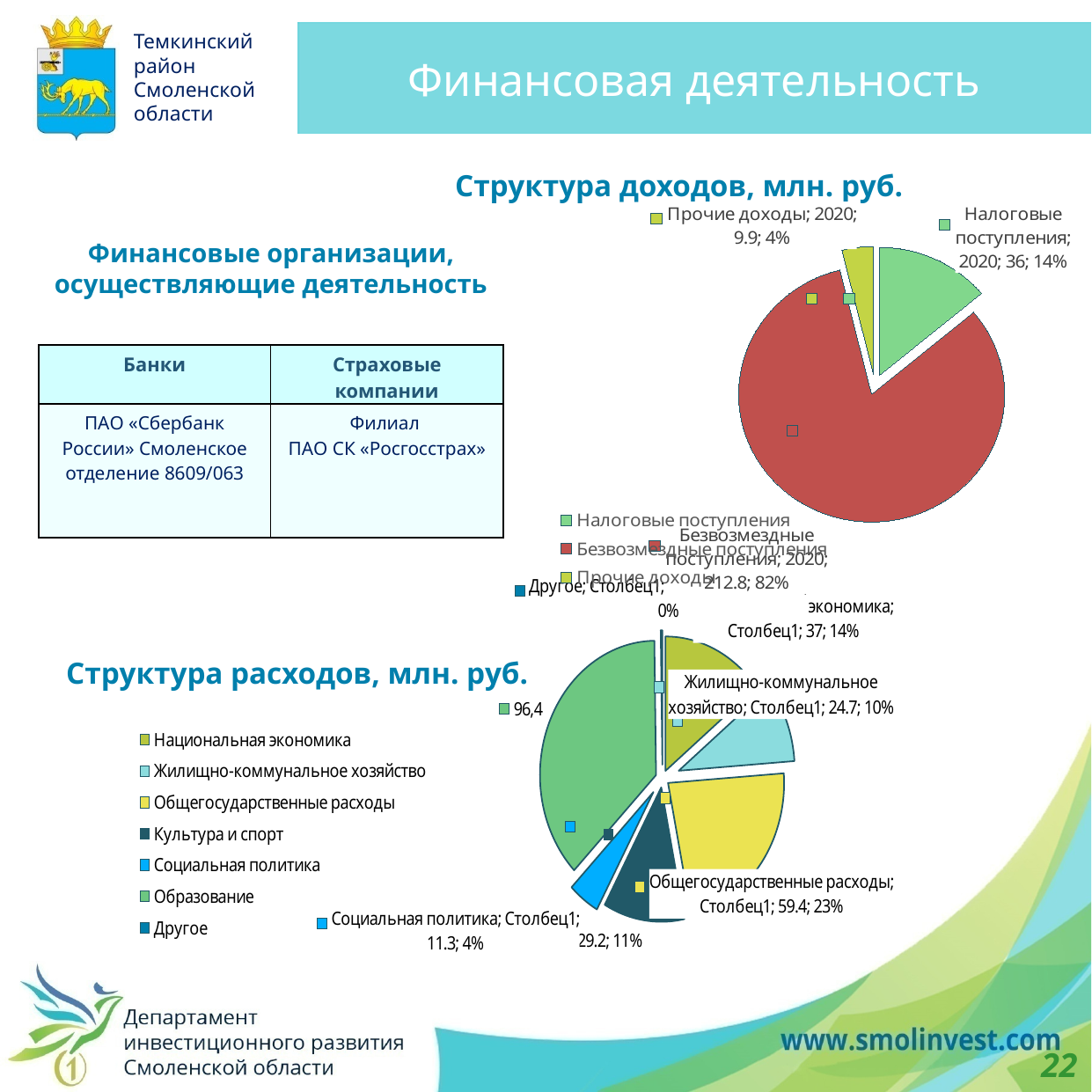
In the 'Структура расходов, млн. руб.' chart, what is the value for Общегосударственные расходы? 59.4 In the 'Структура доходов, млн. руб.' chart, what share of the pie is Налоговые поступления? 14% In the 'Структура доходов, млн. руб.' chart, which category is the largest? Безвозмездные поступления How many categories does the 'Структура доходов, млн. руб.' chart show? 3 How many entries does the legend of the 'Структура расходов, млн. руб.' chart list? 7 In the 'Структура доходов, млн. руб.' chart, what is the difference between Налоговые поступления and Прочие доходы? 26.1 In the 'Структура расходов, млн. руб.' chart, which category is the largest? Образование What kind of chart is the 'Структура доходов, млн. руб.' chart? pie chart In the 'Структура расходов, млн. руб.' chart, which is larger: Национальная экономика or Жилищно-коммунальное хозяйство? Национальная экономика In the 'Структура расходов, млн. руб.' chart, what share of the pie is Социальная политика? 4% In the 'Структура доходов, млн. руб.' chart, which category is the smallest? Прочие доходы In the 'Структура доходов, млн. руб.' chart, what is the value for Безвозмездные поступления? 212.8